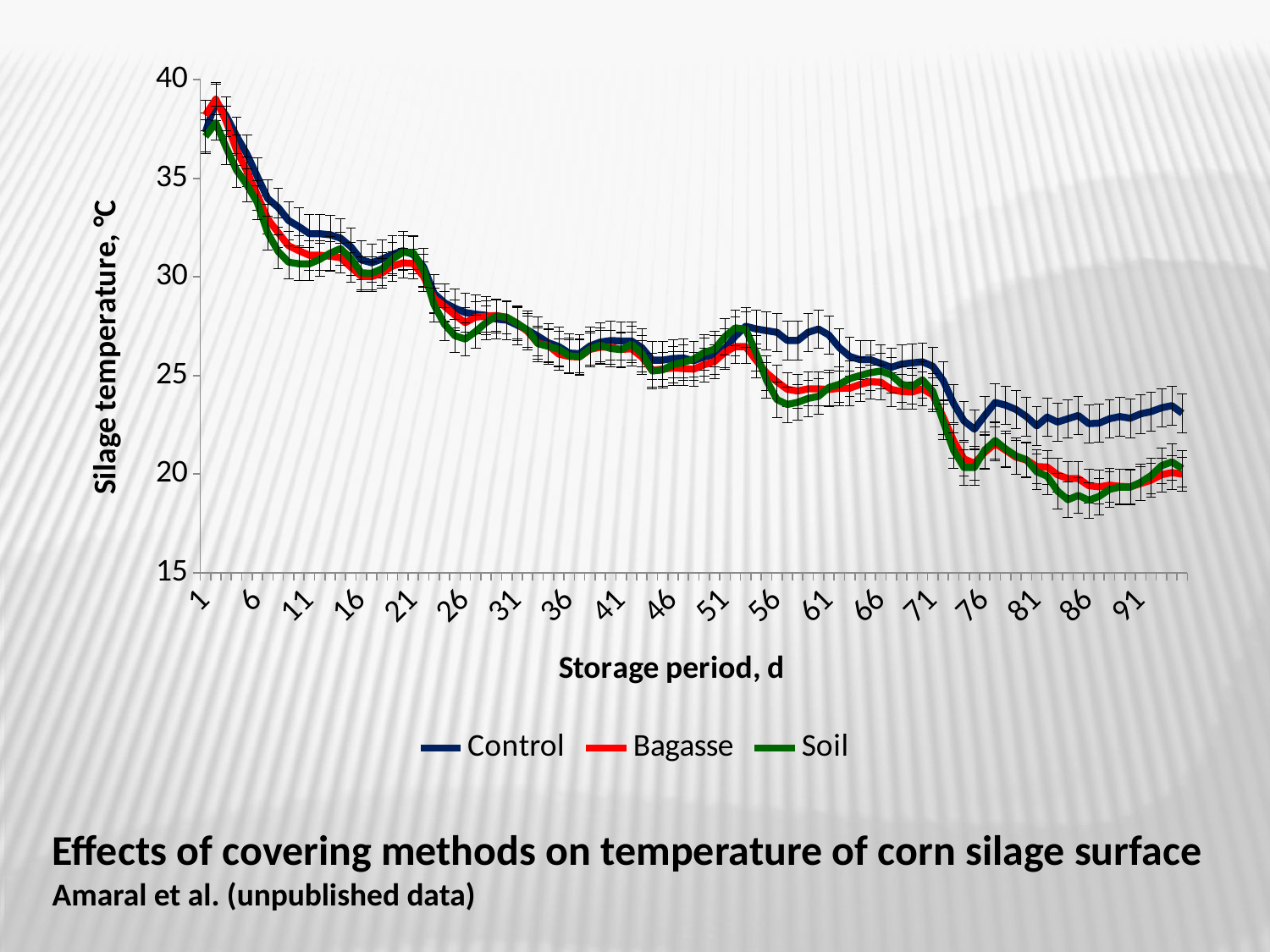
Is the Control temperature at day 1 greater or less than 35? greater What kind of chart is shown on the slide? line chart Do the silage temperatures generally rise or fall as the storage period increases? fall Which series has the highest temperature at day 86? Control At day 86, which series has the higher temperature, Control or Soil? Control Is the Control temperature at day 61 greater or less than 25? greater What is the title of the vertical axis? Silage temperature, °C At day 61, which series has the higher temperature, Control or Bagasse? Control Is the Soil temperature at day 86 greater or less than 20? less What are the series names listed in the legend? Control, Bagasse, Soil How many series does the legend list? 3